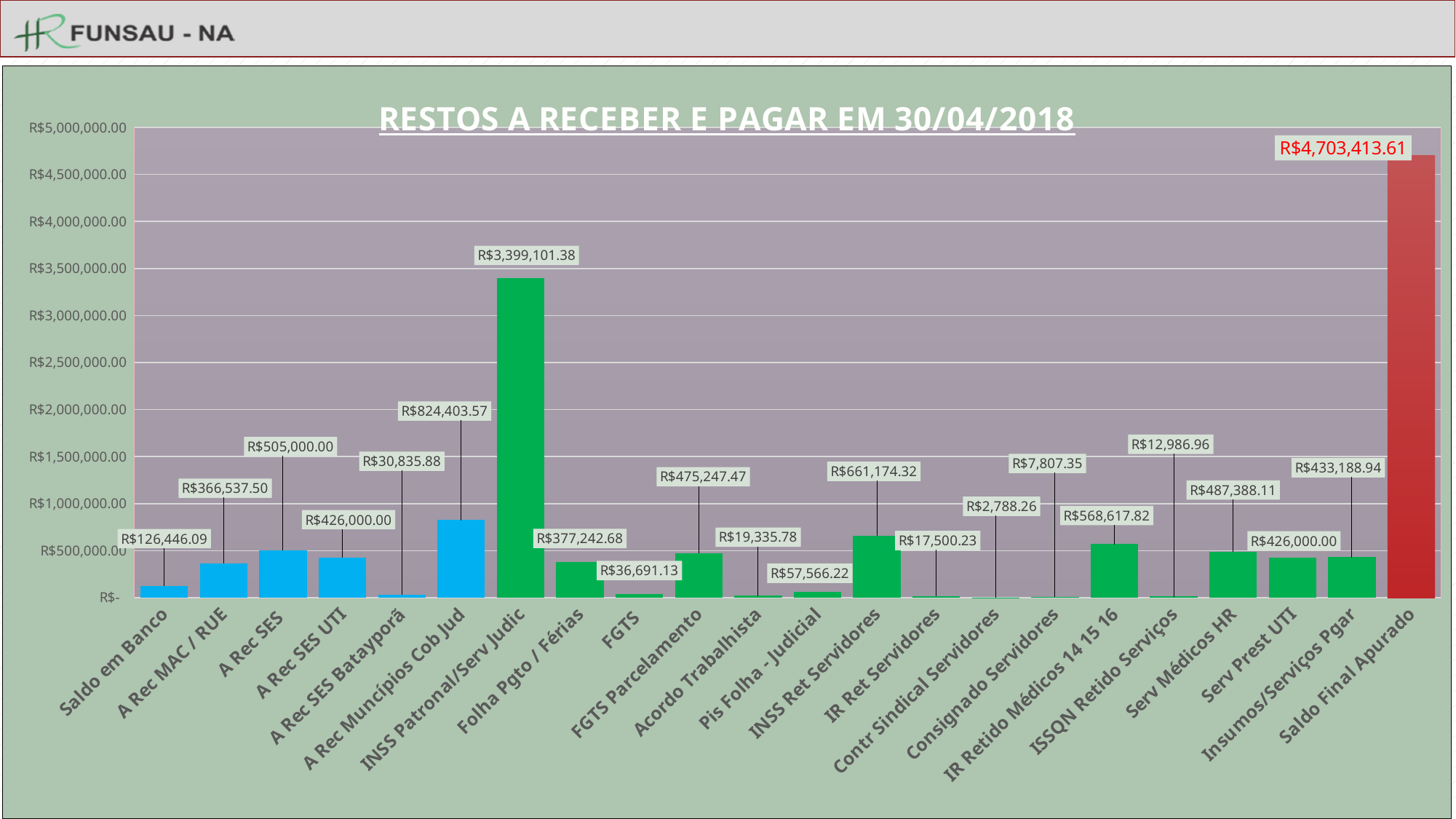
Which is larger, A Rec Muncípios Cob Jud or INSS Ret Servidores? A Rec Muncípios Cob Jud Is the value for Saldo Final Apurado greater or less than R$4,500,000.00? greater How many categories are shown on the x axis? 22 What is the difference between Saldo Final Apurado and INSS Patronal/Serv Judic? R$1,304,312.23 What is the value for A Rec Muncípios Cob Jud? R$824,403.57 What kind of chart is shown on the slide? bar chart Which category has the highest value? Saldo Final Apurado Which category has the lowest value? Contr Sindical Servidores What is the value for Saldo em Banco? R$126,446.09 What is the difference between A Rec SES and A Rec SES UTI? R$79,000.00 What is the value for IR Retido Médicos 14 15 16? R$568,617.82 What is the value for INSS Patronal/Serv Judic? R$3,399,101.38